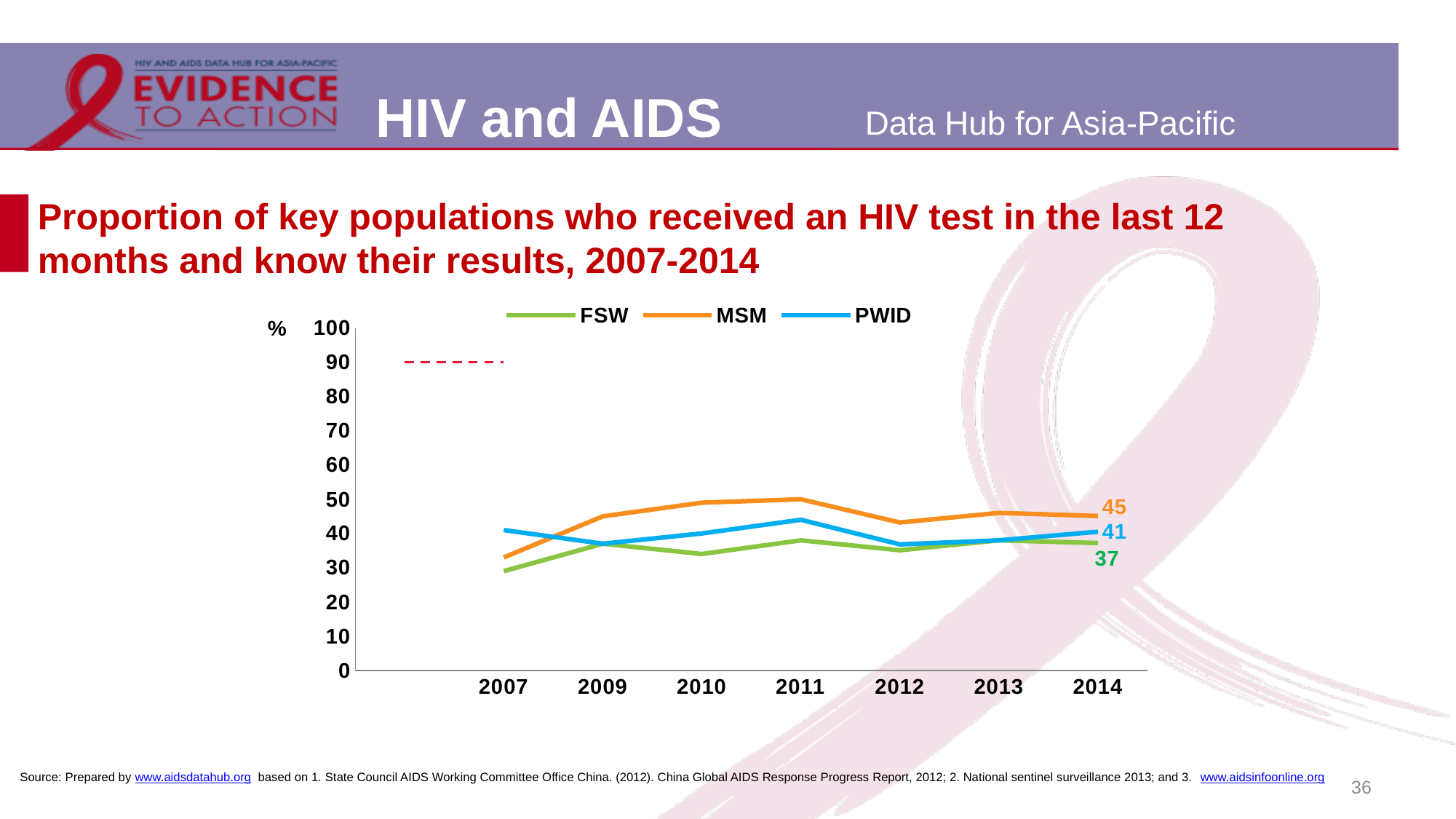
Is the value for MSM in 2011 greater or less than 40? greater What is the difference between the MSM and FSW values in 2014? 8 Which series has the lowest value in 2014? FSW Is the value for FSW in 2007 greater or less than 40? less How many years are shown on the x axis? 7 What is the value for MSM in 2014? 45 In 2014, which is larger, the value for MSM or the value for PWID? MSM How many series does the legend list? 3 Which series has the highest value in 2014? MSM What is the value for PWID in 2014? 41 What is the value for FSW in 2014? 37 What kind of chart is shown on the slide? Line chart